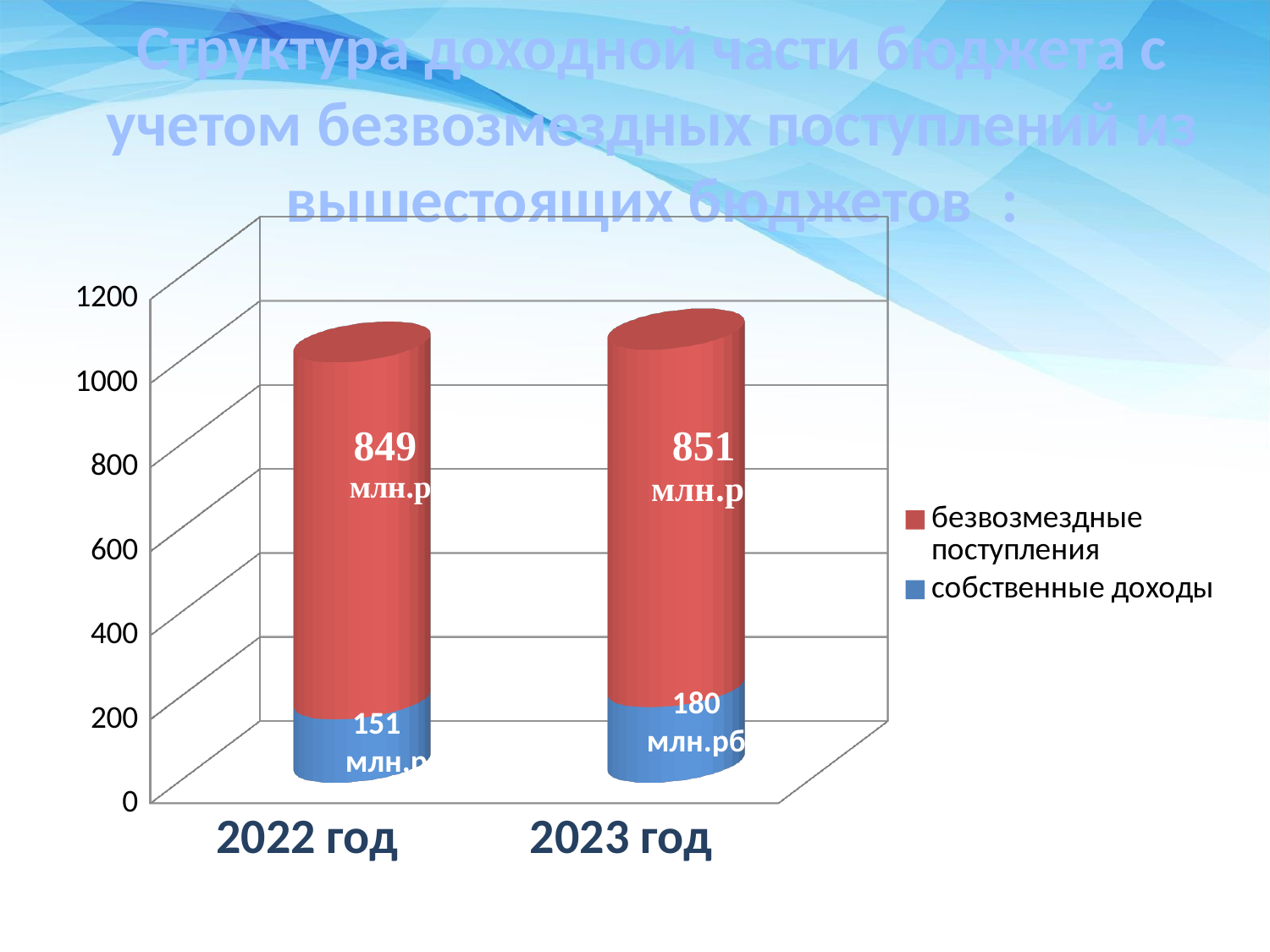
How many series does the legend list? 2 What is the value of собственные доходы for 2023 год? 180 What is the total of the stacked bar for 2023 год? 1031 What is the value of безвозмездные поступления for 2023 год? 851 What is the total of the stacked bar for 2022 год? 1000 How many categories are shown on the x axis? 2 Which year has the higher value of собственные доходы? 2023 год What is the difference in собственные доходы between 2023 год and 2022 год? 29 Is the value of безвозмездные поступления for 2022 год larger or smaller than собственные доходы for 2022 год? larger What is the value of собственные доходы for 2022 год? 151 What is the value of безвозмездные поступления for 2022 год? 849 What kind of chart is shown on the slide? stacked bar chart